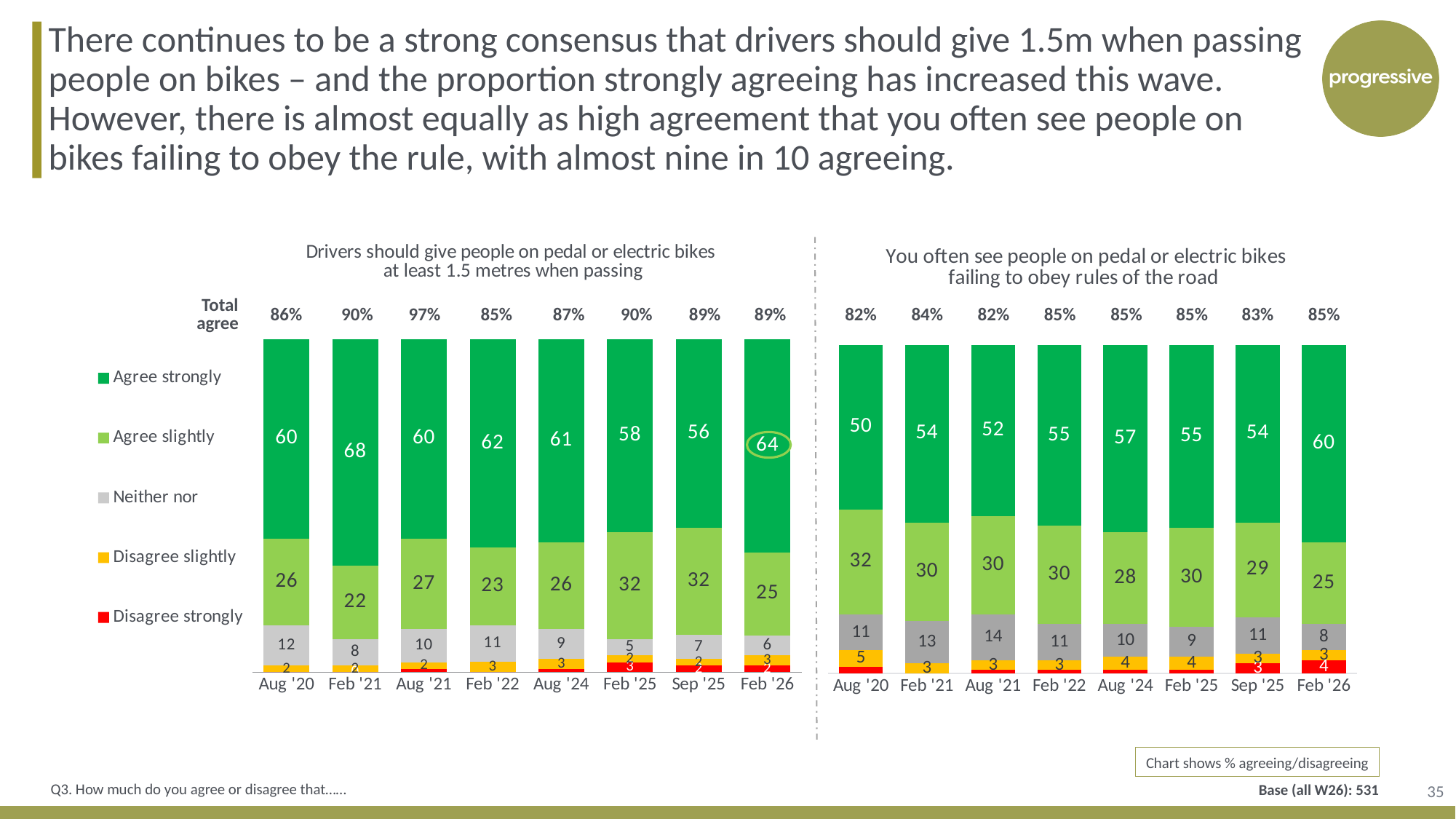
In the left chart (drivers should give at least 1.5 metres when passing), what is the Total agree figure for Aug '21? 97% In the right chart (people on bikes failing to obey rules of the road), what is the Neither nor value for Aug '21? 14 In the left chart (drivers should give at least 1.5 metres when passing), what is the Agree slightly value for Feb '25? 32 In the left chart (drivers should give at least 1.5 metres when passing), what is the Agree strongly value for Feb '26? 64 What kind of chart is used on this slide? Stacked bar chart How many waves (bars) are shown in the right chart (people on bikes failing to obey rules of the road)? 8 In the right chart (people on bikes failing to obey rules of the road), what is the Agree strongly value for Feb '26? 60 How many series does the legend list? 5 In the left chart (drivers should give at least 1.5 metres when passing), what is the difference between the Agree strongly values for Feb '21 and Sep '25? 12 In the right chart (people on bikes failing to obey rules of the road), is the Agree slightly value larger for Aug '20 or Feb '26? Aug '20 In the left chart (drivers should give at least 1.5 metres when passing), which wave has the highest Total agree figure? Aug '21 In the right chart (people on bikes failing to obey rules of the road), which wave has the lowest Agree strongly value? Aug '20